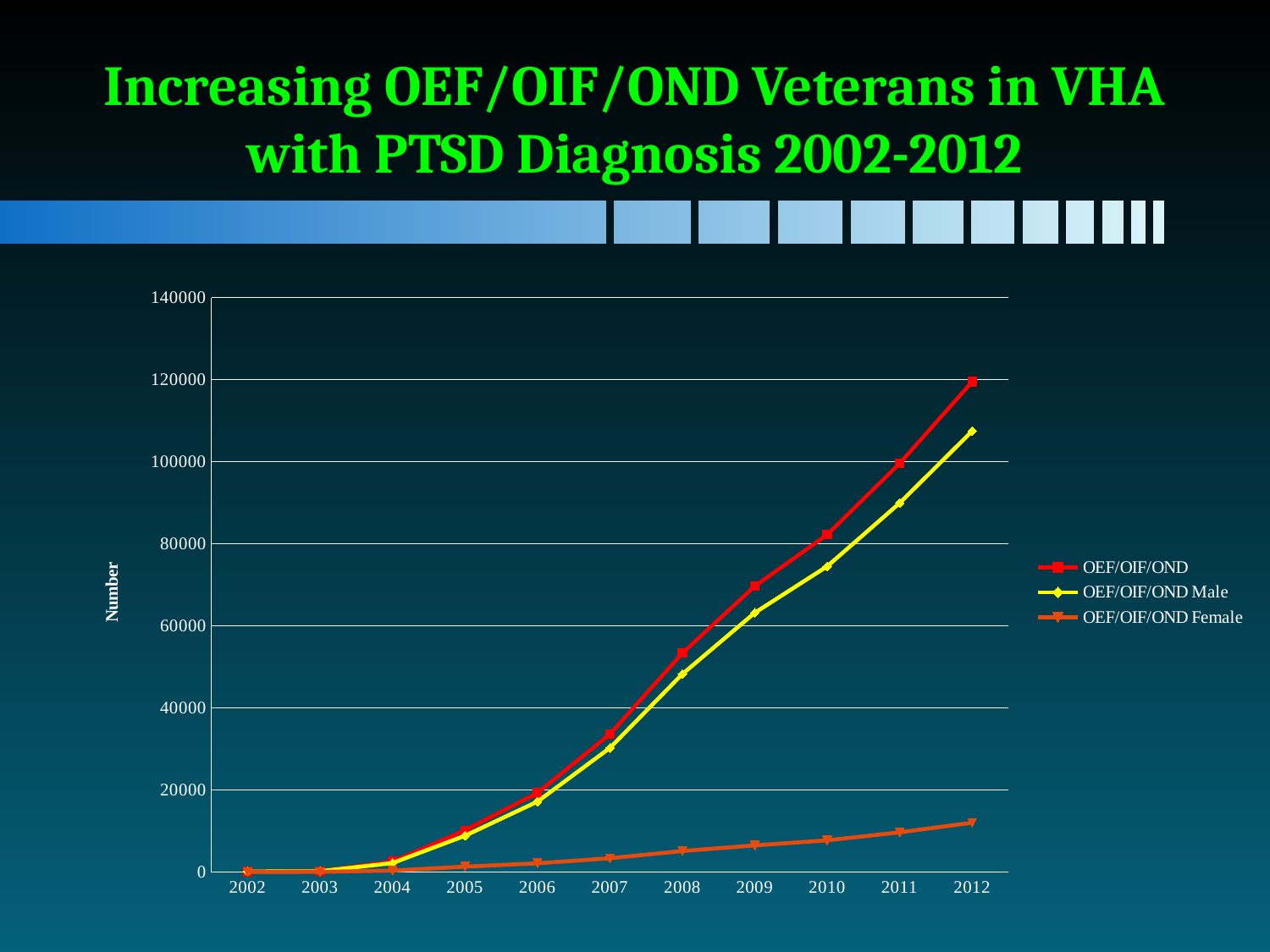
Is the value for OEF/OIF/OND Female in 2012 greater or less than 20000? less In 2012, which is larger: OEF/OIF/OND Male or OEF/OIF/OND Female? OEF/OIF/OND Male In which year is the OEF/OIF/OND series highest? 2012 Which series has the lowest values across the chart? OEF/OIF/OND Female Is the value for OEF/OIF/OND Male in 2010 greater or less than 80000? less How many years are plotted along the x axis? 11 Is the value for OEF/OIF/OND in 2008 greater or less than 40000? greater Do the values for OEF/OIF/OND rise or fall from 2002 to 2012? rise What is the label on the y axis? Number How many series does the legend list? 3 What kind of chart is shown on the slide? line chart